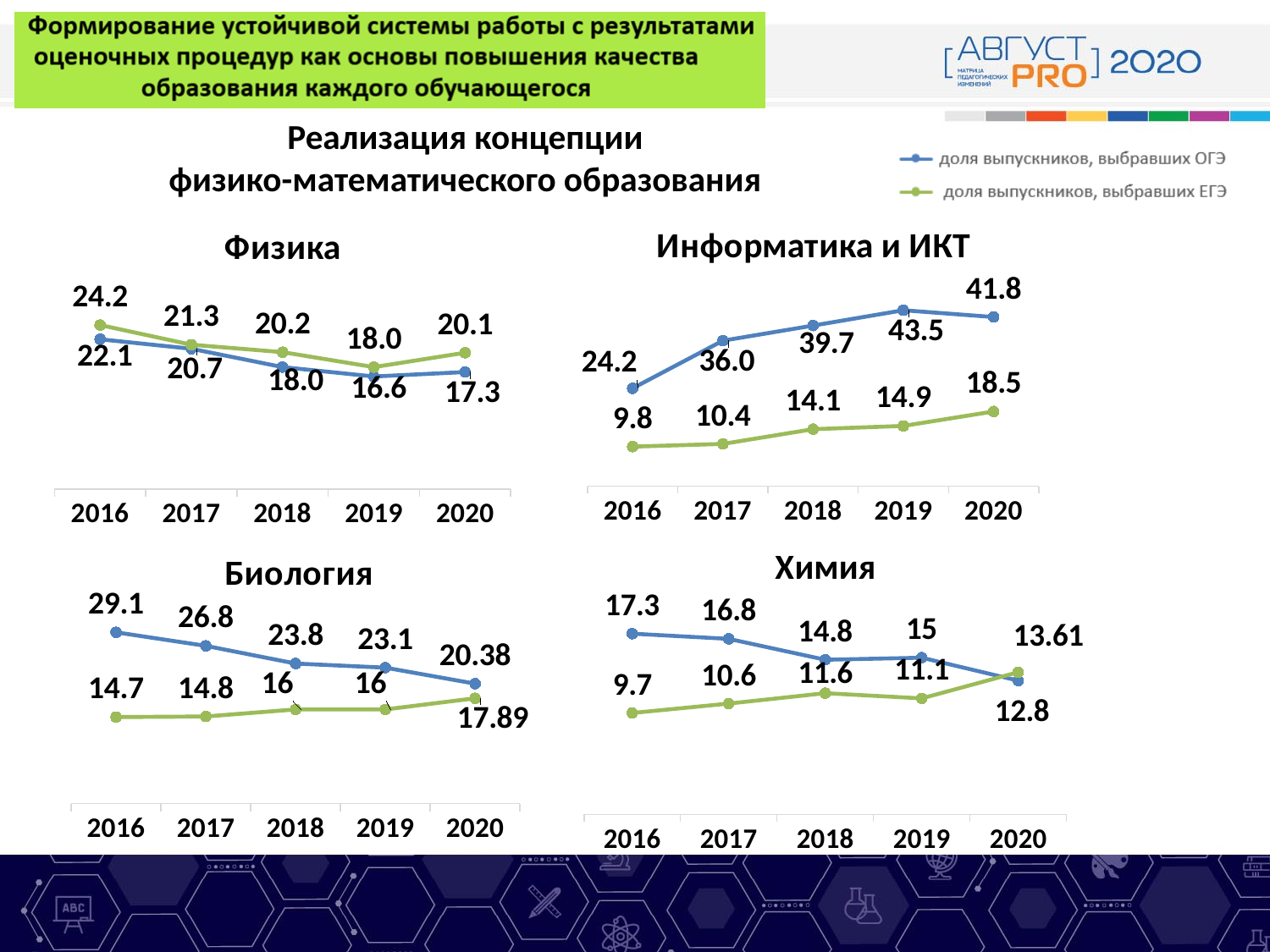
In the Биология chart, does the ОГЭ series (blue) rise or fall from 2016 to 2020? fall In the Информатика и ИКТ chart, in which year does the ОГЭ series (blue) reach its highest value? 2019 How many years are shown on the x axis of the Химия chart? 5 What type of chart is the Физика chart? line chart In the Информатика и ИКТ chart, what is the value of the ЕГЭ series (green) in 2018? 14.1 In the Информатика и ИКТ chart, what is the difference between the ОГЭ and ЕГЭ values in 2020? 23.3 In the Физика chart, what is the value of the ЕГЭ series (green) in 2020? 20.1 In the Химия chart, what is the value of the ЕГЭ series (green) in 2017? 10.6 In the Физика chart, what is the value of the ОГЭ series (blue) in 2016? 22.1 In the Биология chart, in which year is the ЕГЭ series (green) lowest? 2016 In the Биология chart, what is the value of the ОГЭ series (blue) in 2020? 20.38 In the Химия chart, which series has the larger value in 2020, ОГЭ or ЕГЭ? ЕГЭ